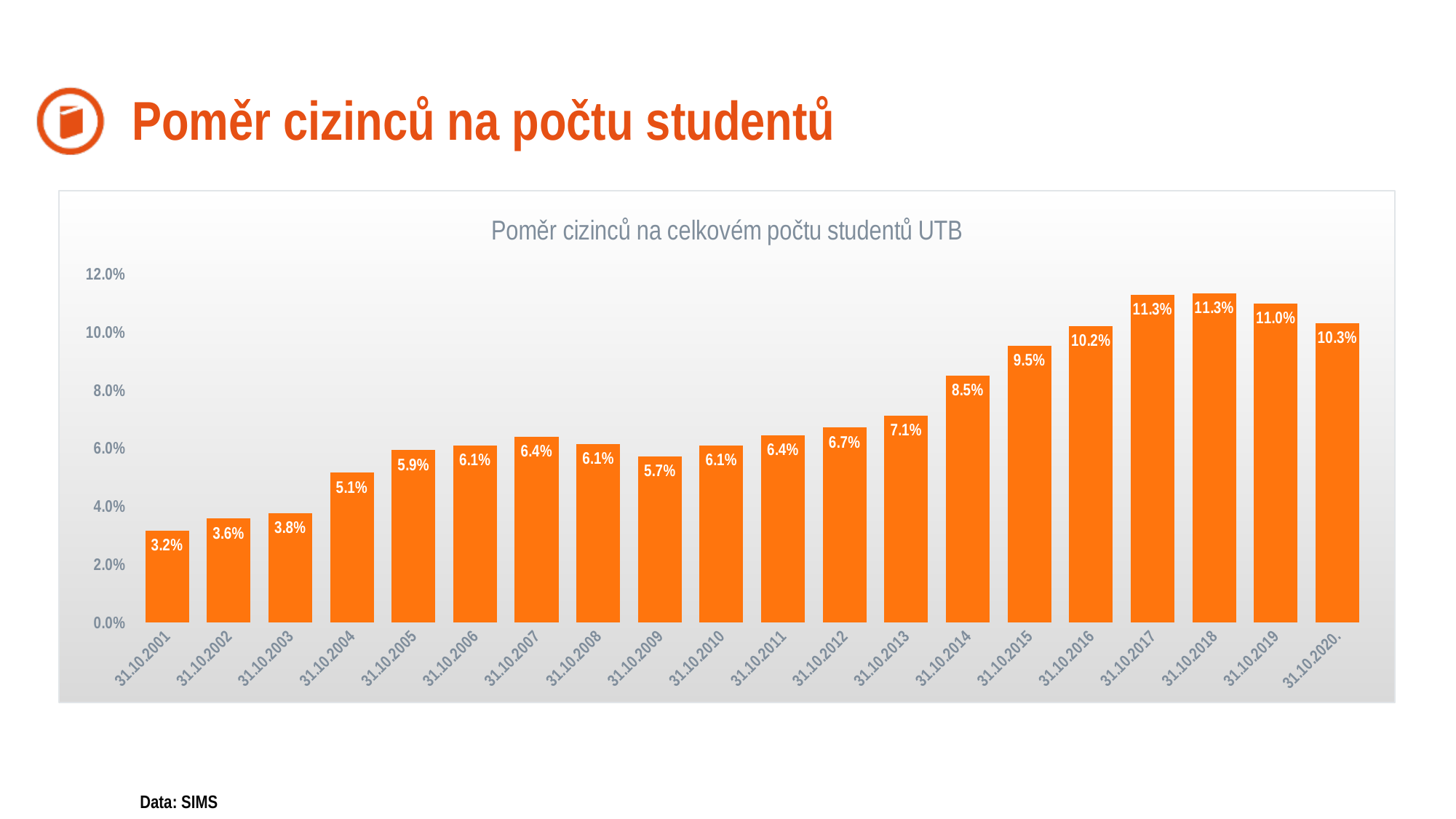
What is the value for 31.10.2020? 10.3% What is the highest value shown in the chart? 11.3% What kind of chart is shown on the slide? bar chart How many bars are shown in the chart? 20 What is the difference between the values for 31.10.2018 and 31.10.2020? 1.0% Which date has the lowest value? 31.10.2001 Which is larger, the value for 31.10.2009 or the value for 31.10.2012? 31.10.2012 What is the value for 31.10.2016? 10.2% What is the value for 31.10.2001? 3.2% Is the value for 31.10.2015 greater or less than 8.0%? greater What is the title of the chart? Poměr cizinců na celkovém počtu studentů UTB What is the difference between the values for 31.10.2014 and 31.10.2013? 1.4%